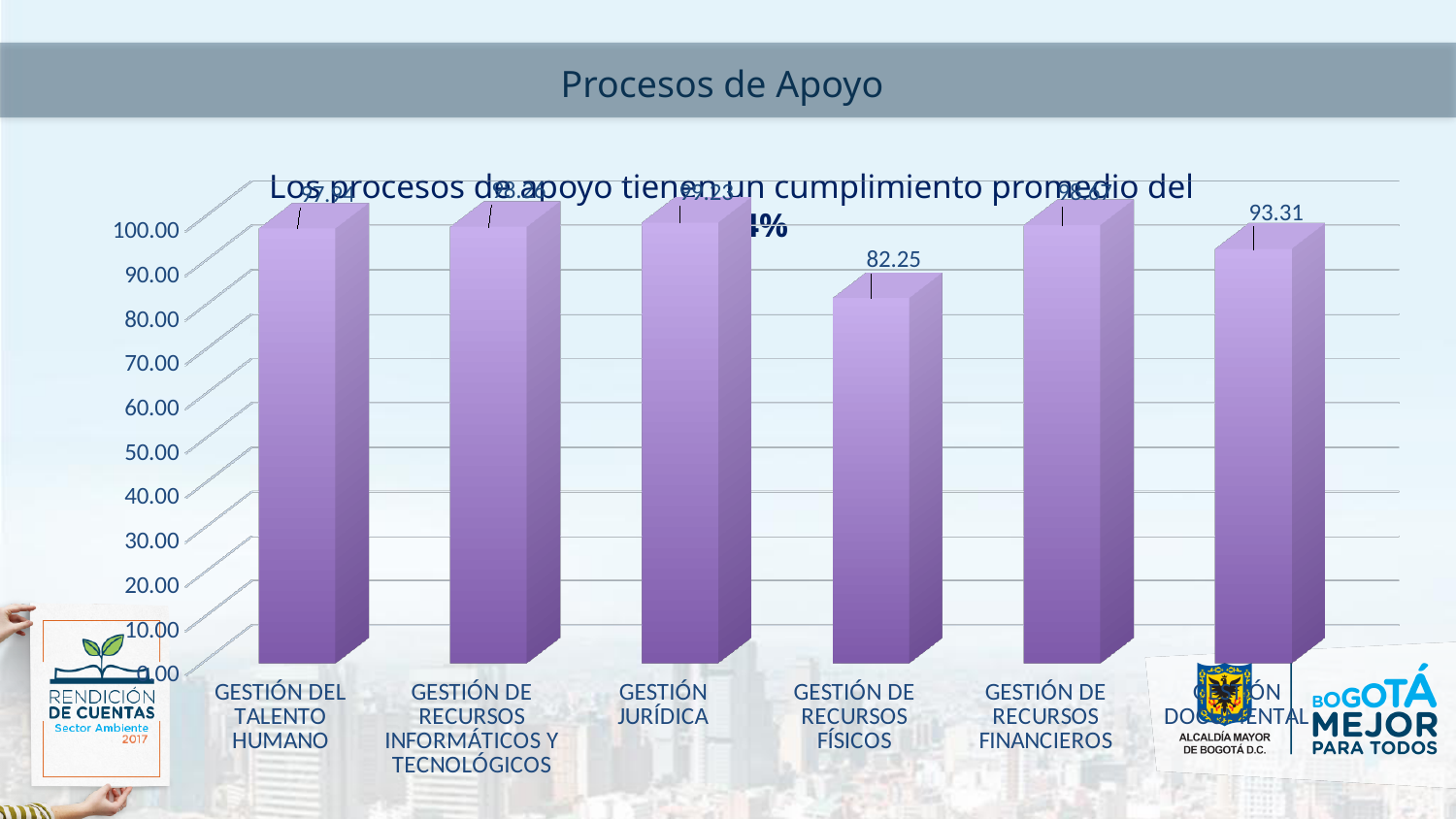
What colour are the bars in the chart? purple What is the value shown on the rightmost bar of the chart? 93.31 Is the value for GESTIÓN DE RECURSOS FÍSICOS greater or less than 90.00? less How many categories are shown on the chart? 6 Is the value for GESTIÓN DE RECURSOS INFORMÁTICOS Y TECNOLÓGICOS greater or less than 80.00? greater Which is larger, the value for GESTIÓN DE RECURSOS FINANCIEROS or the value of the rightmost bar? GESTIÓN DE RECURSOS FINANCIEROS What is the difference between the rightmost bar (93.31) and GESTIÓN DE RECURSOS FÍSICOS (82.25)? 11.06 What is the value for GESTIÓN DE RECURSOS FÍSICOS? 82.25 What kind of chart is shown on the slide? bar chart Is the value for GESTIÓN DEL TALENTO HUMANO greater or less than 90.00? greater Which category has the lowest value? GESTIÓN DE RECURSOS FÍSICOS Which is larger, the value for GESTIÓN JURÍDICA or the value for GESTIÓN DE RECURSOS FÍSICOS? GESTIÓN JURÍDICA